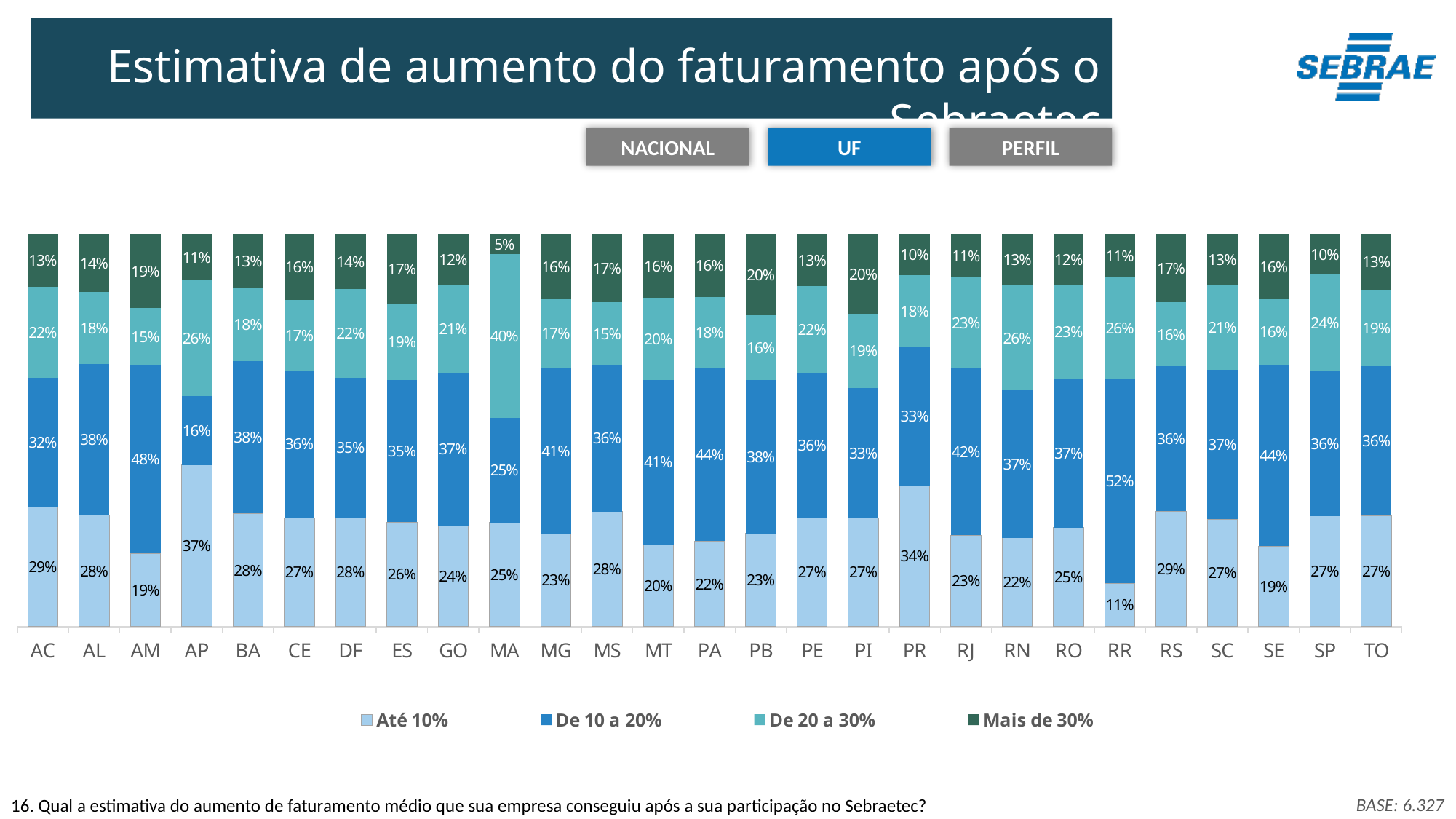
What is the value of the 'De 10 a 20%' series for RR? 52% How many states are shown on the x axis? 27 Which state has the lowest value for the 'Até 10%' series? RR What is the value of the 'De 20 a 30%' series for MA? 40% What kind of chart is shown on the slide? Stacked bar chart How many series does the legend list? 4 Which state has the lowest value for the 'Mais de 30%' series? MA Which is larger: the 'Até 10%' value for PR or for SE? PR What is the value of the 'Mais de 30%' series for PB? 20% Which state has the highest value for the 'De 10 a 20%' series? RR What is the difference between the 'De 10 a 20%' values for AM and AP? 32% What is the value of the 'Até 10%' series for AP? 37%